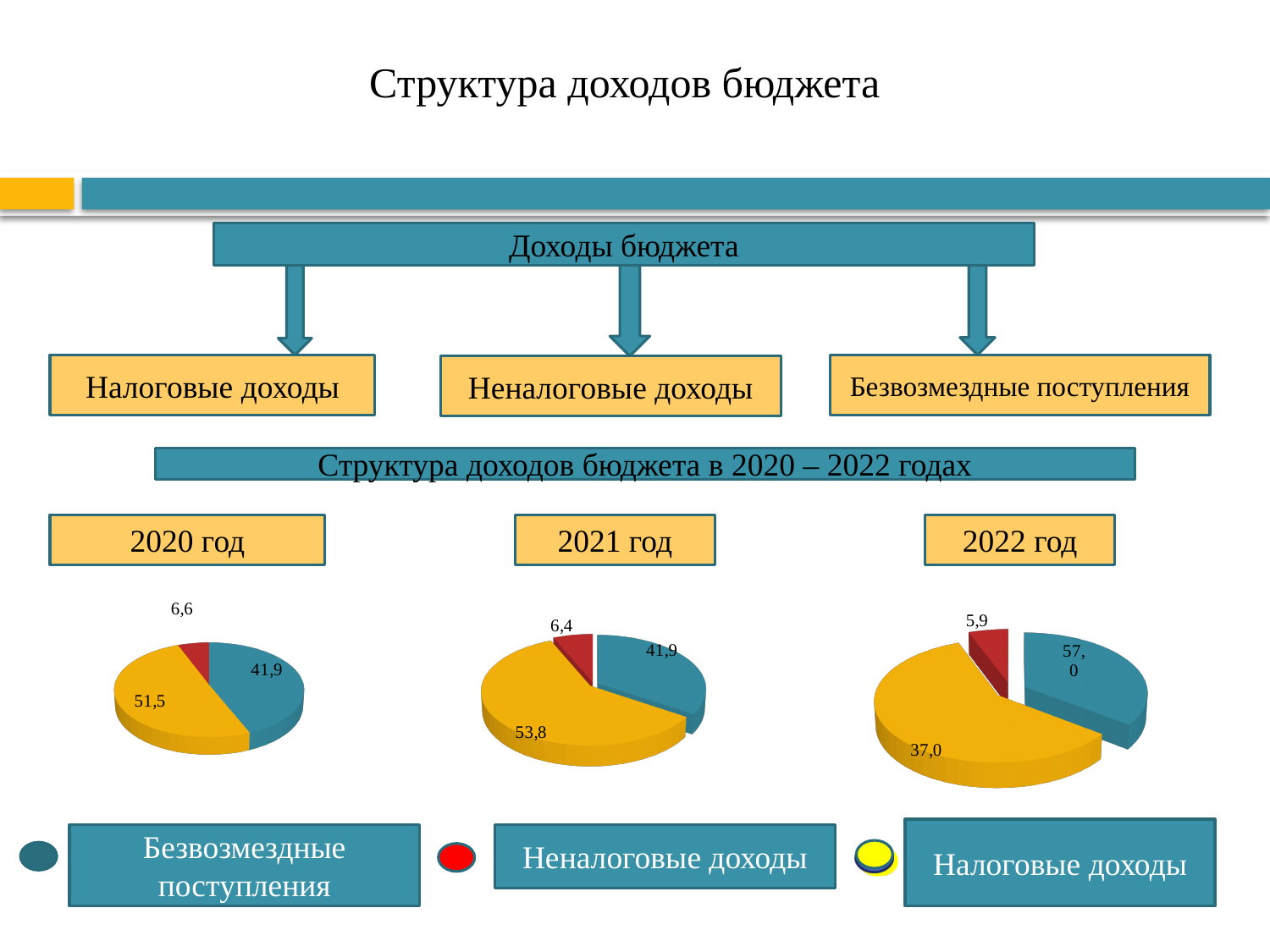
On the 2022 год pie chart, what is the value for Неналоговые доходы? 5,9 On the 2020 год pie chart, which category has the largest slice? Налоговые доходы On the 2021 год pie chart, which is larger: Налоговые доходы or Безвозмездные поступления? Налоговые доходы On the 2020 год pie chart, what is the value for Налоговые доходы? 51,5 On the 2021 год pie chart, what is the value for Безвозмездные поступления? 41,9 On the 2020 год pie chart, what is the value for Неналоговые доходы? 6,6 On the 2020 год pie chart, what is the difference between Налоговые доходы and Безвозмездные поступления? 9,6 How many pie charts are shown on the slide? 3 On the 2021 год pie chart, which category has the smallest slice? Неналоговые доходы How many slices does the 2021 год pie chart have? 3 On the 2021 год pie chart, what is the value for Налоговые доходы? 53,8 What kind of chart is used for the 2020 год, 2021 год and 2022 год data? Pie chart